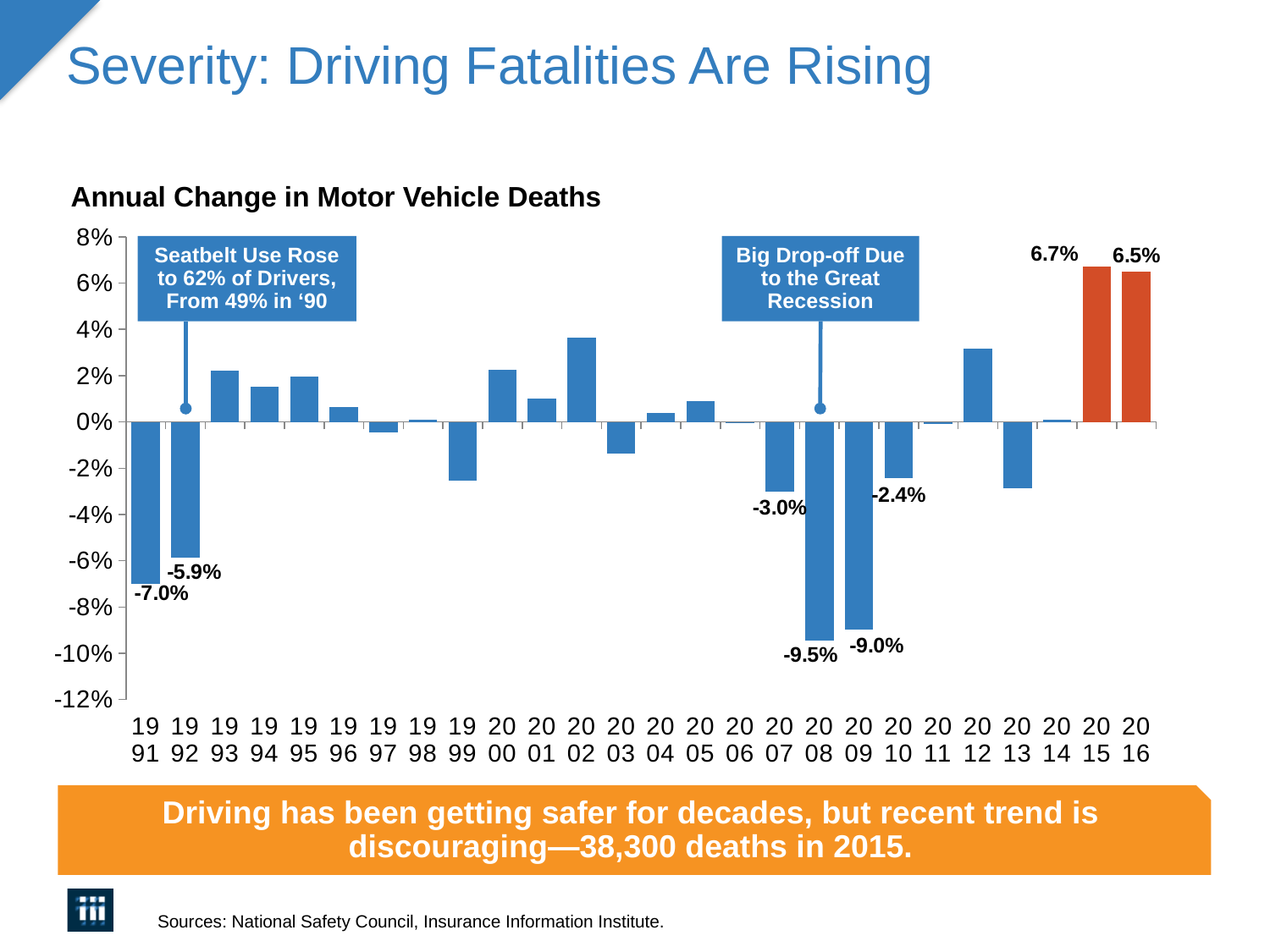
Which year has the highest annual change in motor vehicle deaths? 2015 Is the value for 2002 greater or less than 2%? greater Which year shows a larger decline, 2008 or 2009? 2008 What is the annual change in motor vehicle deaths shown for 2008? -9.5% Which year has the lowest annual change in motor vehicle deaths? 2008 How many years are shown on the x axis of the chart? 26 What type of chart is used to show the annual change in motor vehicle deaths? Bar chart What is the difference between the 1991 value and the 1992 value? 1.1 percentage points What value is labeled for 1991? -7.0% What is the annual change in motor vehicle deaths shown for 2015? 6.7% What value is labeled for 2010? -2.4% By how many percentage points does the 2015 value exceed the 2016 value? 0.2 percentage points